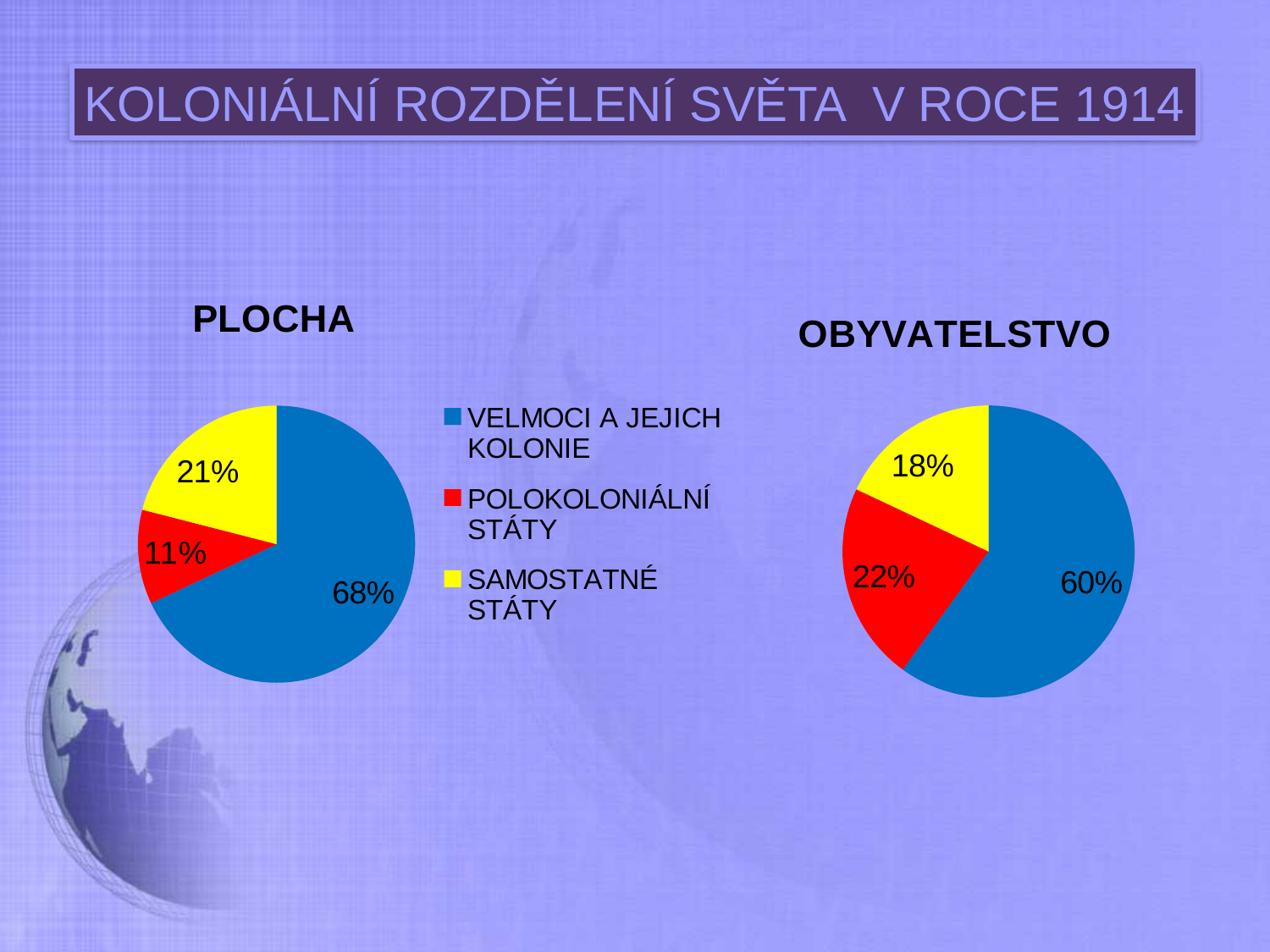
In the OBYVATELSTVO pie chart, what share is shown for VELMOCI A JEJICH KOLONIE? 60% What is the difference between the VELMOCI A JEJICH KOLONIE share in the PLOCHA chart and in the OBYVATELSTVO chart? 8% In the OBYVATELSTVO pie chart, what share is shown for POLOKOLONIÁLNÍ STÁTY? 22% In the PLOCHA pie chart, what share is shown for VELMOCI A JEJICH KOLONIE? 68% Which chart shows a larger share for POLOKOLONIÁLNÍ STÁTY, PLOCHA or OBYVATELSTVO? OBYVATELSTVO In the PLOCHA pie chart, which category has the largest slice? VELMOCI A JEJICH KOLONIE In the PLOCHA pie chart, what share is shown for POLOKOLONIÁLNÍ STÁTY? 11% How many categories does the legend list? 3 What type of chart is used for PLOCHA and OBYVATELSTVO? Pie chart In the PLOCHA pie chart, what share is shown for SAMOSTATNÉ STÁTY? 21% In the OBYVATELSTVO pie chart, what share is shown for SAMOSTATNÉ STÁTY? 18% In the OBYVATELSTVO pie chart, which category has the smallest slice? SAMOSTATNÉ STÁTY